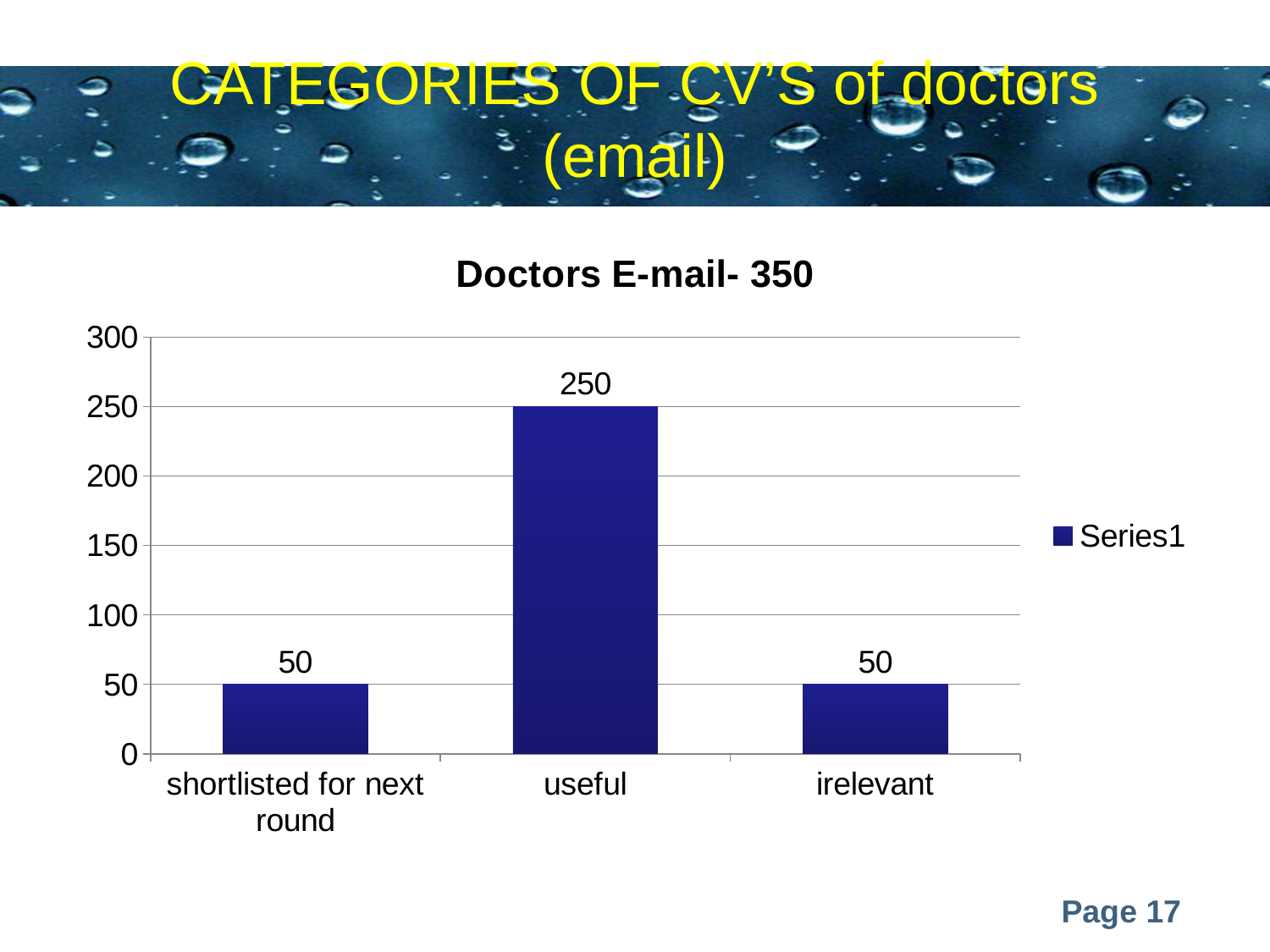
What is the value for irelevant? 50 What is the value for shortlisted for next round? 50 How many series does the legend list? 1 How many categories are shown on the x axis? 3 Which is larger, the value for useful or the value for shortlisted for next round? useful What is the value for useful? 250 What is the difference between the values for useful and irelevant? 200 Is the value for irelevant greater or less than 100? less Is the value for useful greater or less than 200? greater What kind of chart is shown? bar chart What is the title of the chart? Doctors E-mail- 350 Which category has the highest value? useful